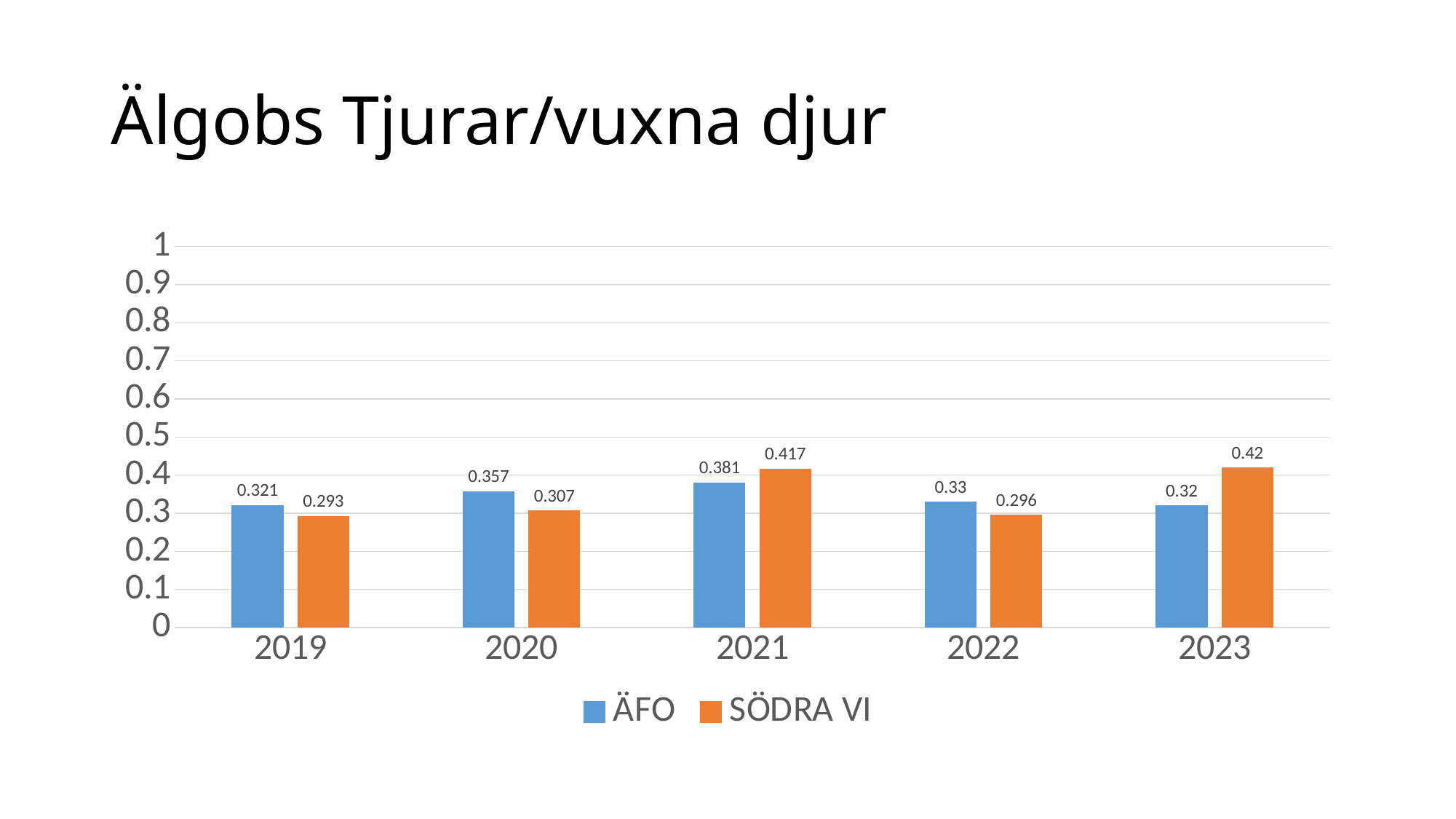
What is the title of the slide? Älgobs Tjurar/vuxna djur How many years are shown on the x axis? 5 What kind of chart is shown? bar chart What is the SÖDRA VI value for 2023? 0.42 What is the difference between the SÖDRA VI and ÄFO values in 2023? 0.1 Which year has the lowest SÖDRA VI value? 2019 What is the SÖDRA VI value for 2019? 0.293 What is the ÄFO value for 2021? 0.381 Is the SÖDRA VI value for 2021 greater or less than 0.4? greater Which is larger in 2020, ÄFO or SÖDRA VI? ÄFO How many series does the legend list? 2 Which year has the highest ÄFO value? 2021